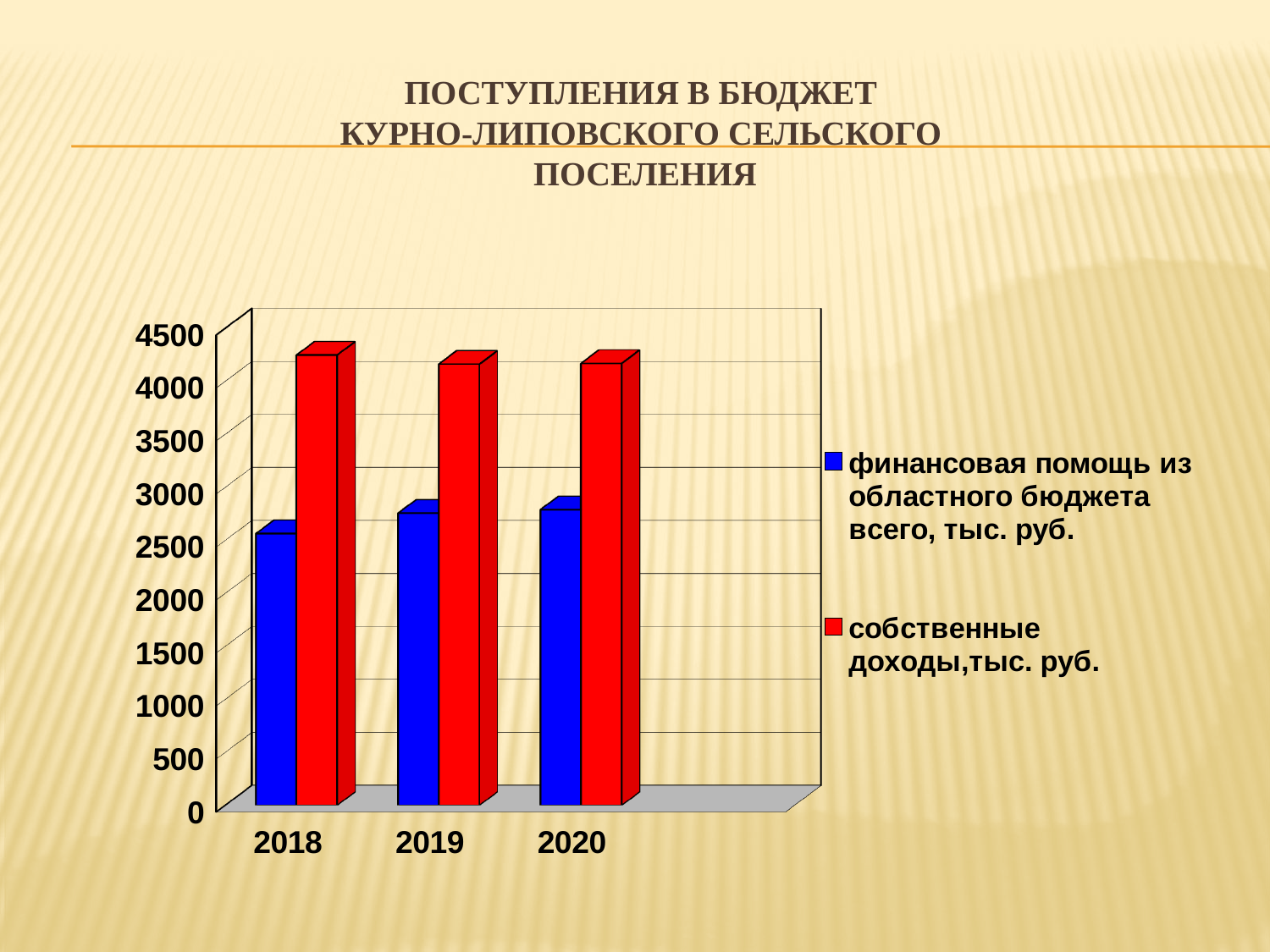
Is the value for собственные доходы in 2020 greater or less than 4500? less In which year is финансовая помощь из областного бюджета the lowest? 2018 How many years are shown on the x axis of the chart? 3 Does финансовая помощь из областного бюджета rise or fall from 2018 to 2020? rise Is the value for финансовая помощь из областного бюджета in 2018 greater or less than 3000? less In 2019, which is larger: финансовая помощь из областного бюджета or собственные доходы? собственные доходы Which series is shown in red in the chart? собственные доходы,тыс. руб. How many series does the chart legend list? 2 What kind of chart is shown on the slide? bar chart Is the value for финансовая помощь из областного бюджета in 2020 greater or less than 2500? greater What is the title of the chart on the slide? ПОСТУПЛЕНИЯ В БЮДЖЕТ КУРНО-ЛИПОВСКОГО СЕЛЬСКОГО ПОСЕЛЕНИЯ